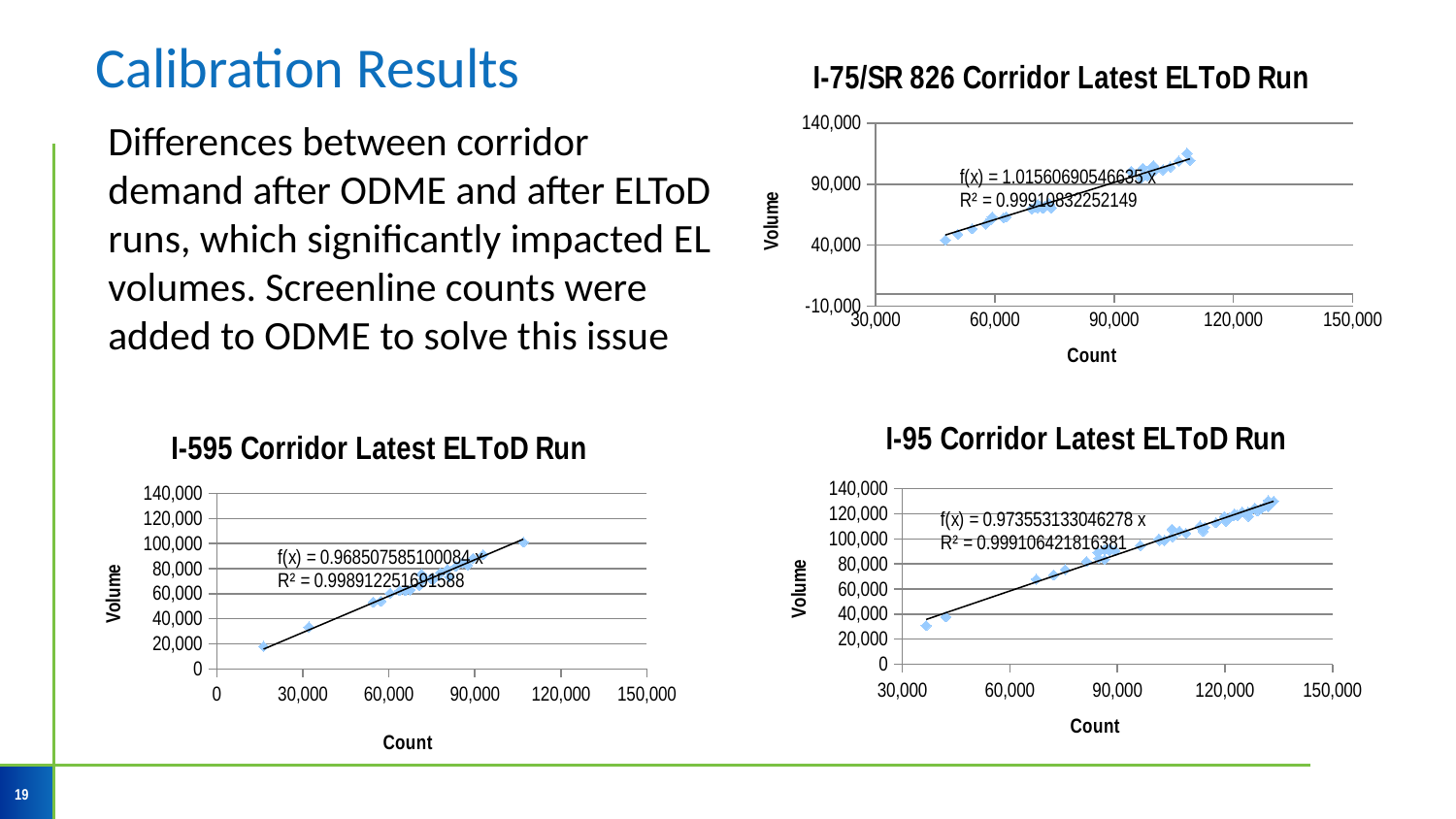
What kind of chart is the 'I-595 Corridor Latest ELToD Run' chart? scatter chart In the 'I-75/SR 826 Corridor Latest ELToD Run' chart, is the volume of the highest point greater or less than 90,000? greater How many charts are shown on the slide? 3 In the 'I-595 Corridor Latest ELToD Run' chart, what is the trendline equation shown? f(x) = 0.968507585100084 x What is the label of the horizontal axis in the 'I-595 Corridor Latest ELToD Run' chart? Count In the 'I-75/SR 826 Corridor Latest ELToD Run' chart, what is the trendline equation shown? f(x) = 1.01560690546635 x What is the label of the vertical axis in the 'I-95 Corridor Latest ELToD Run' chart? Volume In the 'I-95 Corridor Latest ELToD Run' chart, do the plotted volumes rise or fall as count increases? rise In the 'I-95 Corridor Latest ELToD Run' chart, what R² value is shown? R² = 0.999106421816381 In the 'I-595 Corridor Latest ELToD Run' chart, is the volume of the rightmost point (at a count of about 107,000) greater or less than 80,000? greater In the 'I-95 Corridor Latest ELToD Run' chart, is the volume of the leftmost point greater or less than 40,000? less In the 'I-75/SR 826 Corridor Latest ELToD Run' chart, what R² value is shown? R² = 0.99910832252149